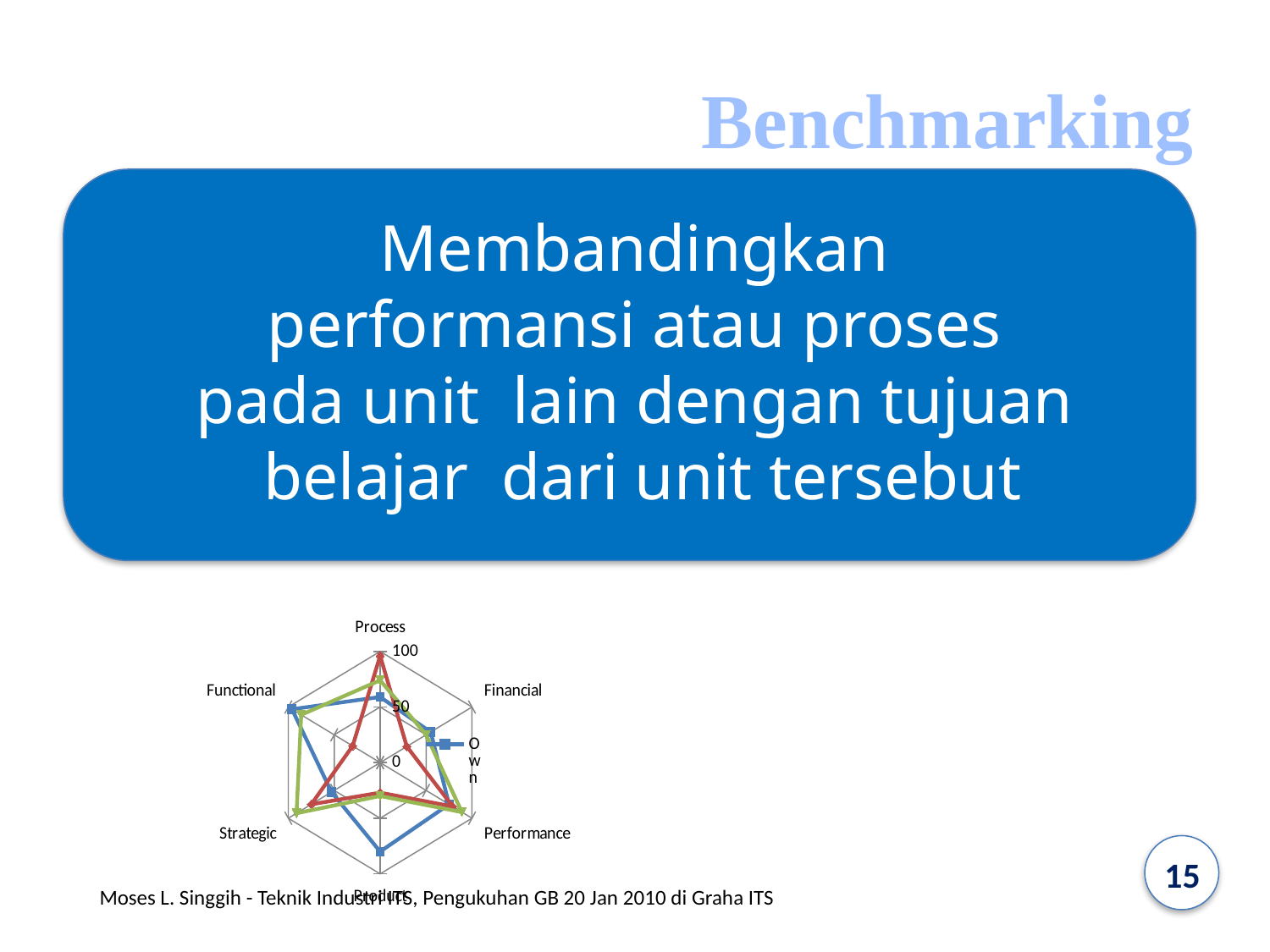
How many lines (series) are plotted on the radar chart? 3 How many categories (axes) does the radar chart have? 6 On which category does the red series reach its highest value? Process What kind of chart is shown on the slide? radar chart Is the red series' value for Process greater or less than 50? greater For the Process category, which series has the larger value, the red or the blue? red What is the highest value shown on the radar chart's axis scale? 100 Is the green series' value for Strategic greater or less than 50? greater Is the green series' value for Functional greater or less than 50? greater